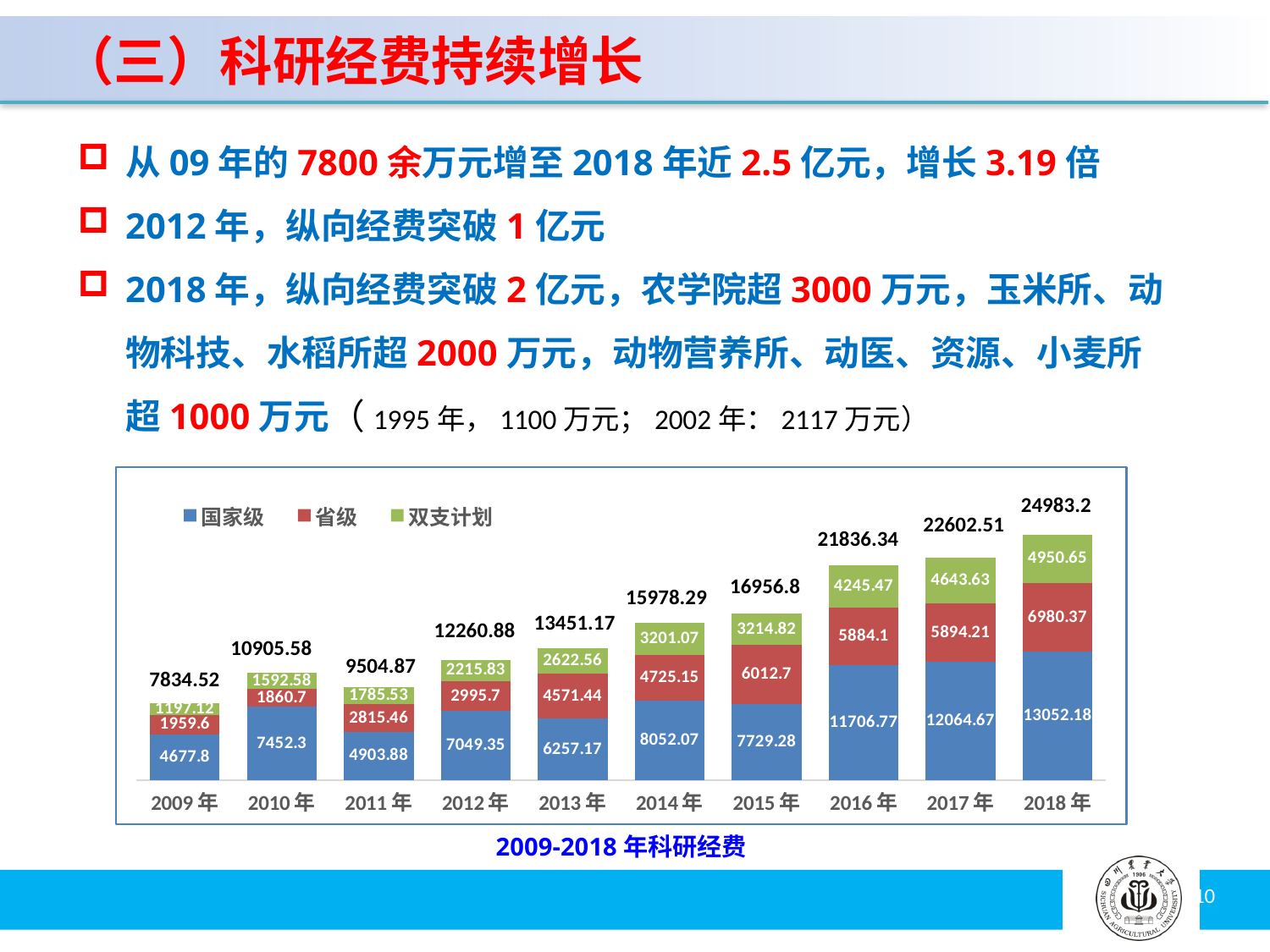
Which year has the highest total? 2018年 Which is larger, the 省级 value for 2014年 or the 省级 value for 2013年? 2014年 What is the total of the stacked bar for 2016年? 21836.34 What is the value of 双支计划 for 2013年? 2622.56 How many years are shown on the x axis of the chart? 10 What is the difference between the 国家级 values for 2018年 and 2017年? 987.51 Which year has the lowest total? 2009年 What is the value of 国家级 for 2018年? 13052.18 What is the caption printed below the chart? 2009-2018年科研经费 How many series does the legend list? 3 What is the value of 省级 for 2015年? 6012.7 What type of chart is shown on the slide? Stacked bar chart